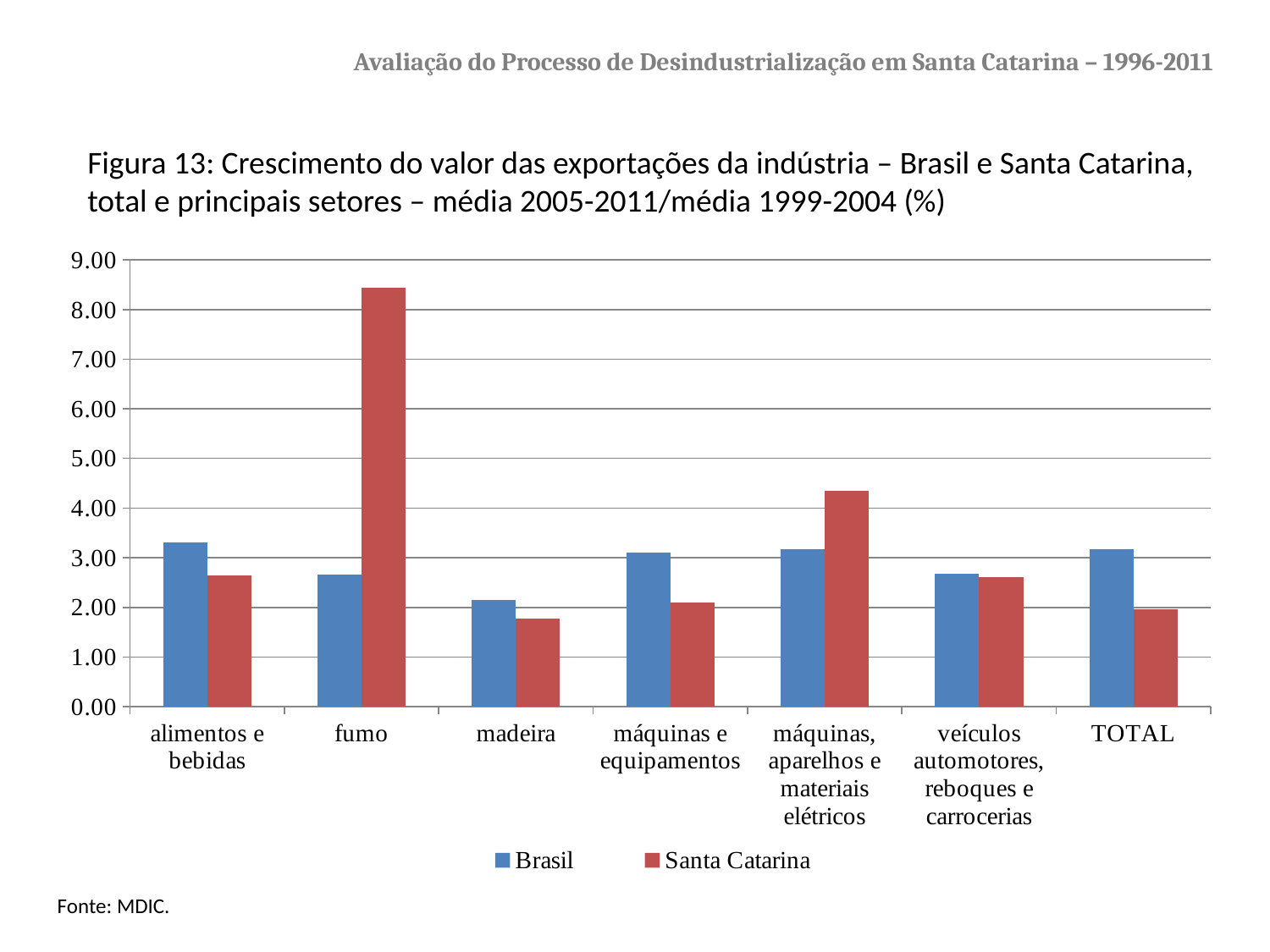
For TOTAL, which is larger: the Brasil value or the Santa Catarina value? Brasil How many categories are shown along the x axis? 7 How many series does the legend list? 2 Is the Santa Catarina value for madeira greater or less than 2.00? less What kind of chart is shown on the slide? bar chart For which category is the Brasil value lowest? madeira For which category is the Santa Catarina value highest? fumo For fumo, which is larger: the Brasil value or the Santa Catarina value? Santa Catarina Which colour represents Santa Catarina in the legend? red Is the Santa Catarina value for fumo greater or less than 8.00? greater Is the Santa Catarina value for máquinas, aparelhos e materiais elétricos greater or less than 4.00? greater